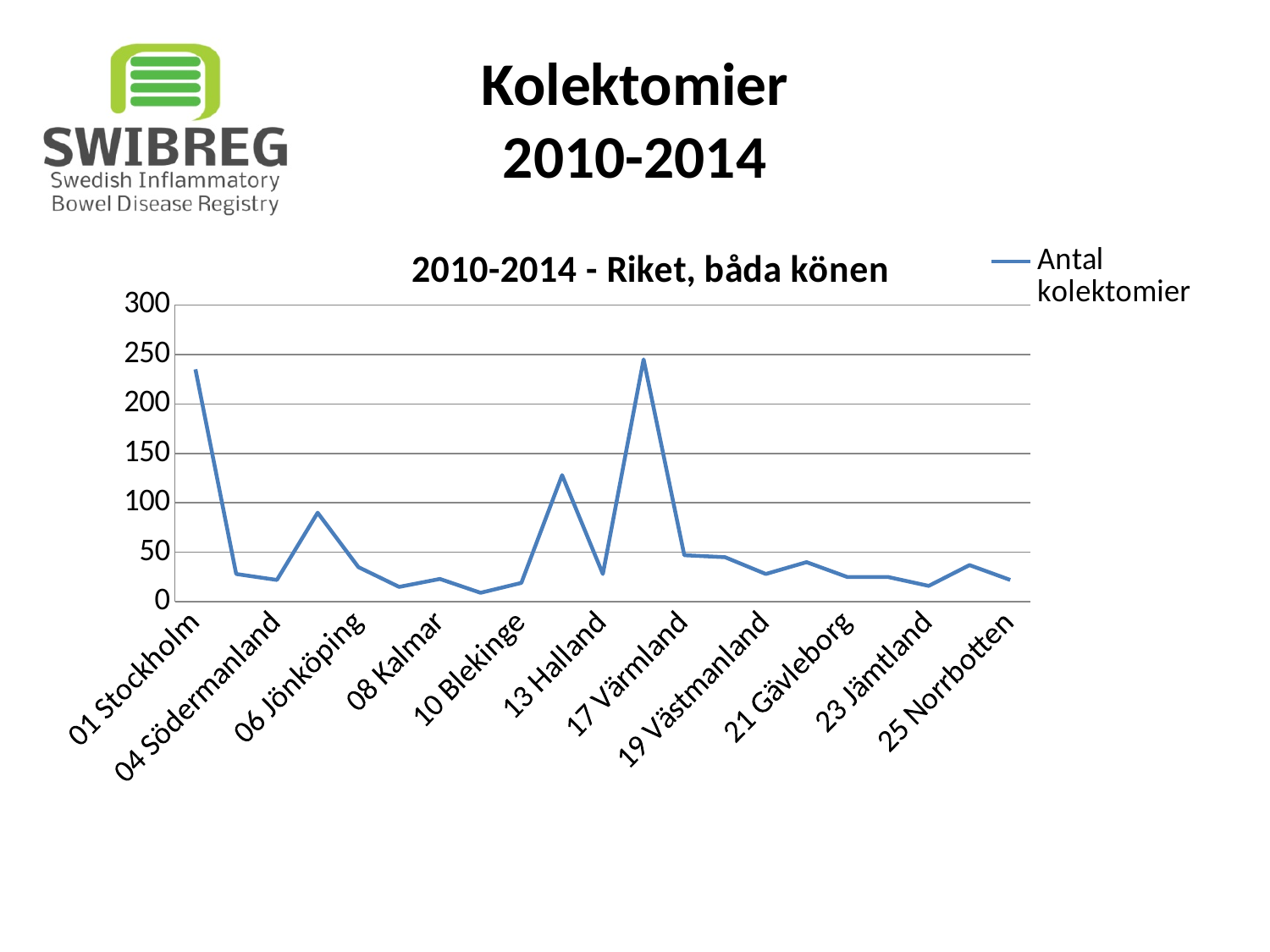
Is the value for 25 Norrbotten greater or less than 50? less Is the value for 13 Halland greater or less than 50? less Which has a higher value, 01 Stockholm or 17 Värmland? 01 Stockholm How many series does the chart legend list? 1 What is the title of the chart? 2010-2014 - Riket, båda könen Is the value for 10 Blekinge greater or less than 50? less Which has a higher value, 01 Stockholm or 25 Norrbotten? 01 Stockholm What is the name of the series shown in the chart legend? Antal kolektomier What kind of chart is shown on the slide? line chart